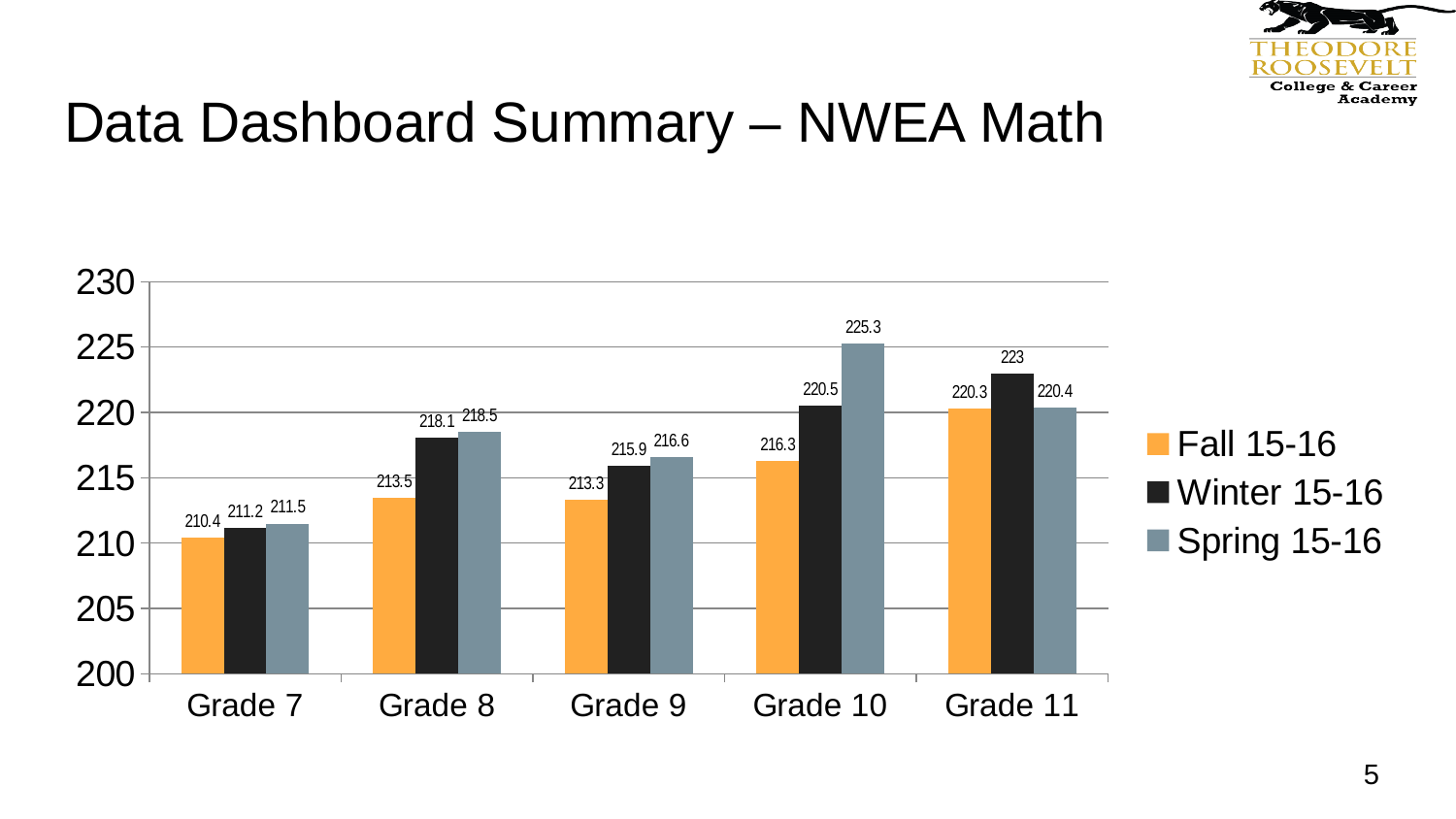
What is the title of the slide containing the chart? Data Dashboard Summary – NWEA Math Is the Winter 15-16 value for Grade 8 greater or less than 215? greater How many grade categories are shown on the x axis? 5 Which grade has the lowest Fall 15-16 value? Grade 7 What is the Spring 15-16 value for Grade 10? 225.3 What is the Winter 15-16 value for Grade 11? 223 What kind of chart is shown on the slide? Bar chart Which grade has the highest Spring 15-16 value? Grade 10 Which is larger for Grade 11: the Winter 15-16 value or the Spring 15-16 value? Winter 15-16 What is the Fall 15-16 value for Grade 7? 210.4 What is the difference between the Spring 15-16 and Fall 15-16 values for Grade 10? 9 How many series does the legend list? 3